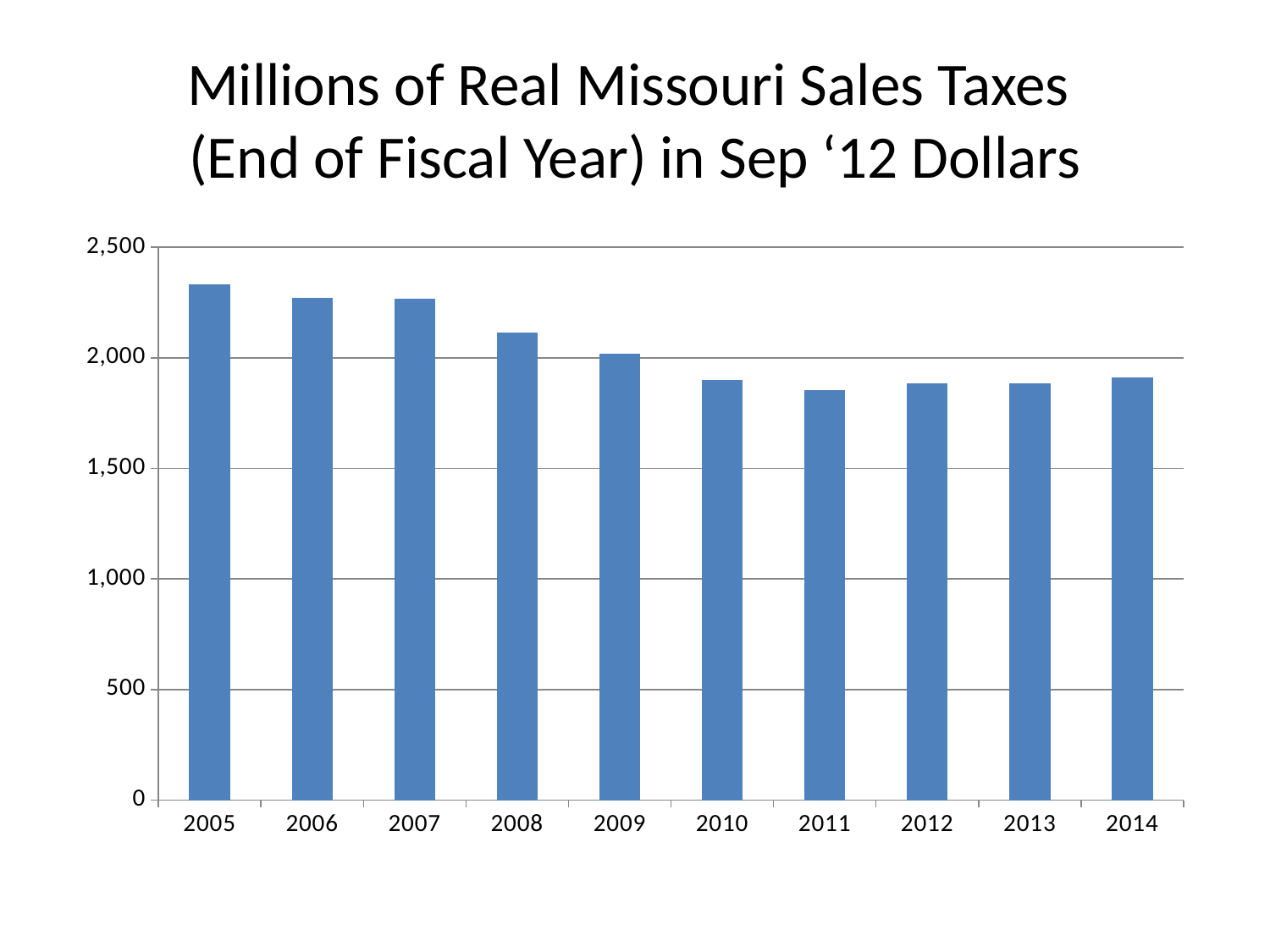
Which is larger, the value for 2008 or the value for 2011? 2008 Is the value for 2005 greater or less than 2,000? greater How many years are plotted on the x axis? 10 Is the value for 2011 greater or less than 1,500? greater Which is larger, the value for 2005 or the value for 2010? 2005 What kind of chart is shown on the slide? bar chart Do the values generally rise or fall from 2005 to 2011? fall Is the value for 2010 greater or less than 2,000? less Which year has the highest value? 2005 What is the title of the chart? Millions of Real Missouri Sales Taxes (End of Fiscal Year) in Sep '12 Dollars